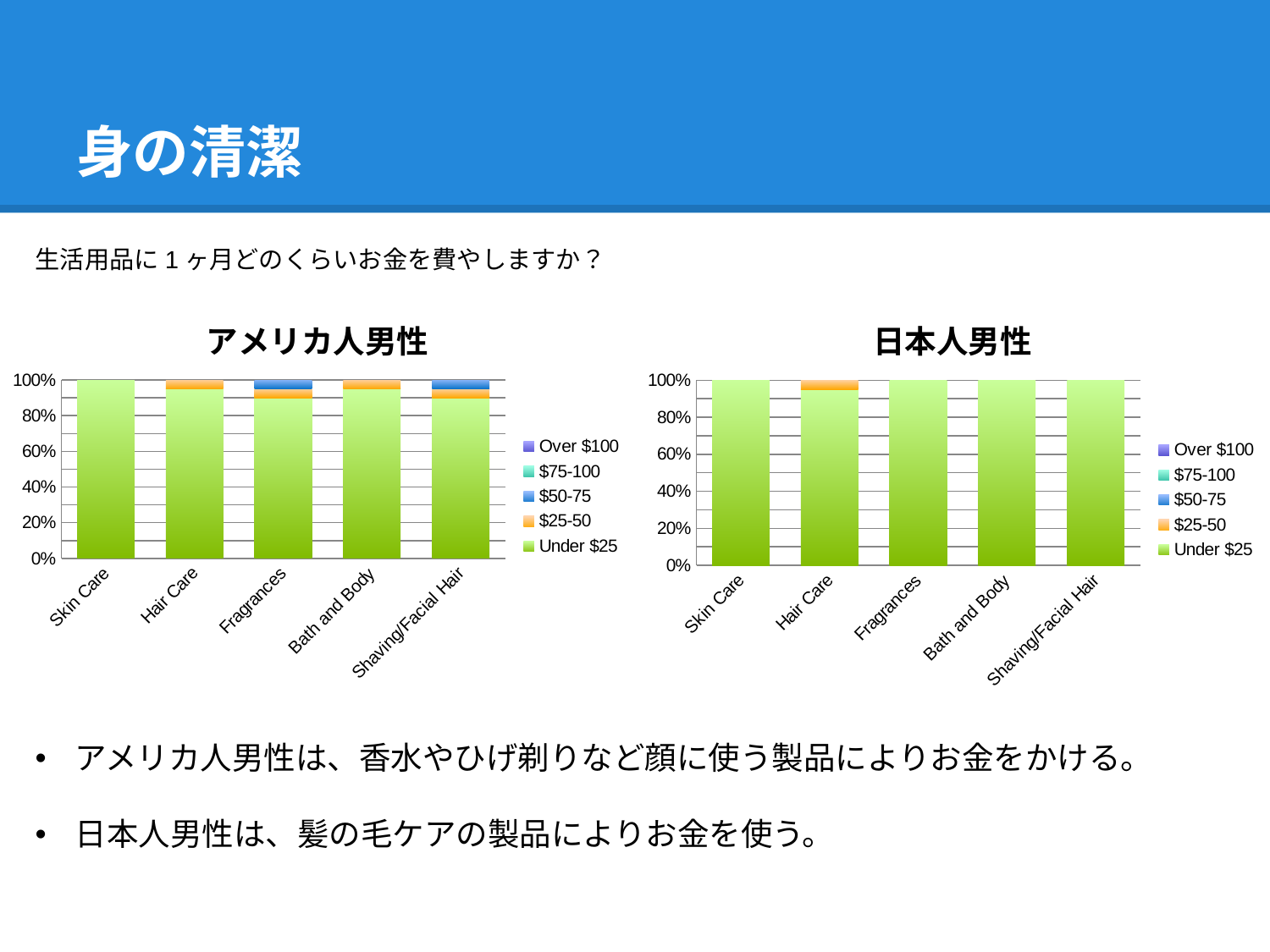
In the 日本人男性 chart, is the Under $25 value for Hair Care greater or less than 80%? greater How many categories are shown on the x axis of the 日本人男性 chart? 5 In the 日本人男性 chart, which category is the only one with a $25-50 segment? Hair Care What kind of chart is the アメリカ人男性 chart? Stacked bar chart In the アメリカ人男性 chart, which category has the lowest Under $25 share? Fragrances and Shaving/Facial Hair (tied) What is the title of the chart on the right? 日本人男性 In the アメリカ人男性 chart, is the Under $25 value for Shaving/Facial Hair greater or less than 80%? greater In the アメリカ人男性 chart, which has the larger Under $25 share, Skin Care or Fragrances? Skin Care In the 日本人男性 chart, is the $25-50 value for Hair Care greater or less than 20%? less How many series does the legend of the アメリカ人男性 chart list? 5